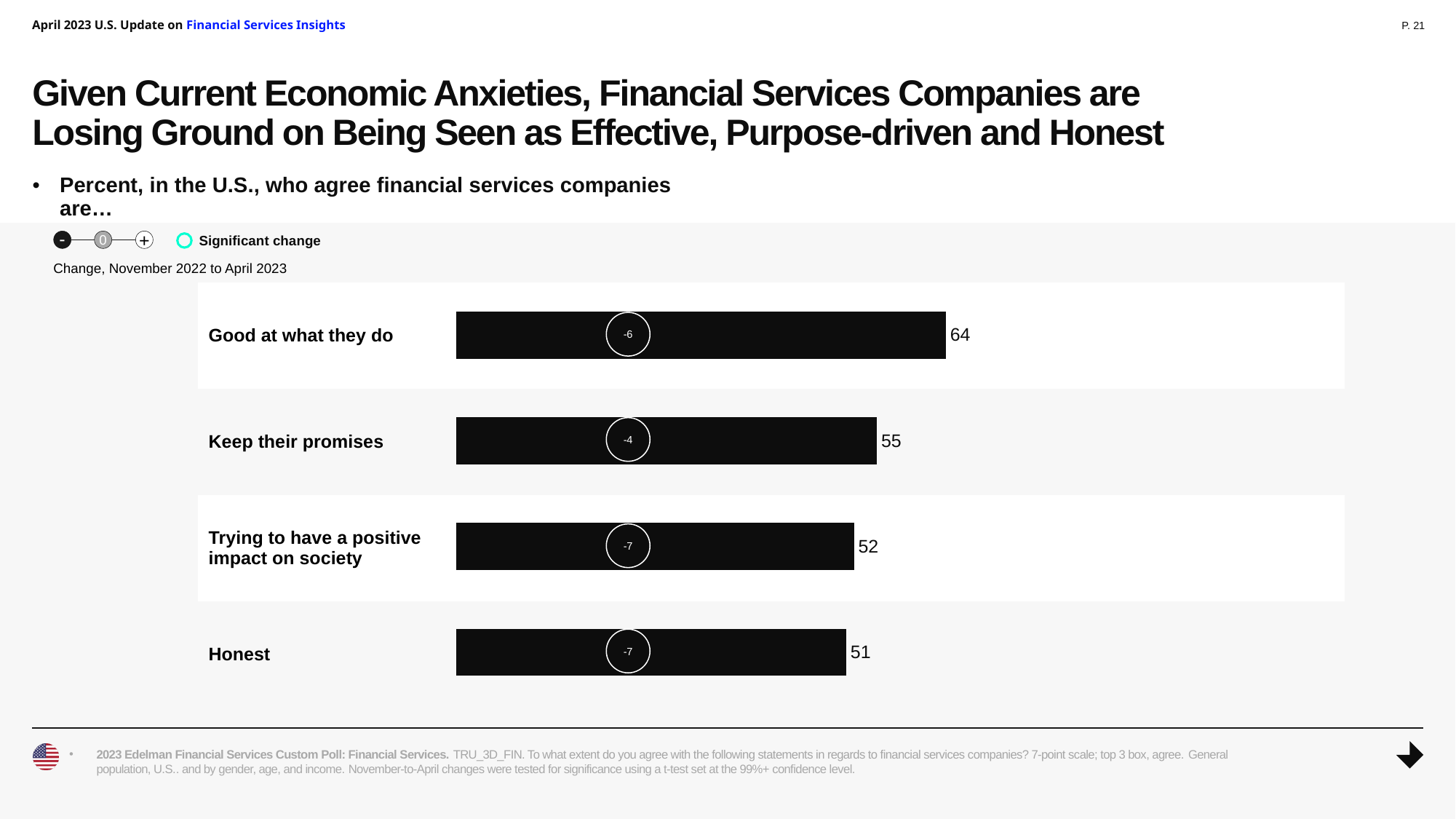
What kind of chart is shown on the slide? Bar chart What percent agree that financial services companies are good at what they do? 64 What is the change from November 2022 to April 2023 shown for 'Honest'? -7 What percent agree that financial services companies keep their promises? 55 What is the change from November 2022 to April 2023 shown for 'Good at what they do'? -6 Which is larger: the value for 'Keep their promises' or the value for 'Trying to have a positive impact on society'? Keep their promises What percent agree that financial services companies are trying to have a positive impact on society? 52 Which statement has the lowest percent agreement? Honest How many statements (categories) are shown in the chart? 4 What percent agree that financial services companies are honest? 51 Which statement has the highest percent agreement? Good at what they do What is the difference between the percent agreeing companies are good at what they do and the percent agreeing they are honest? 13